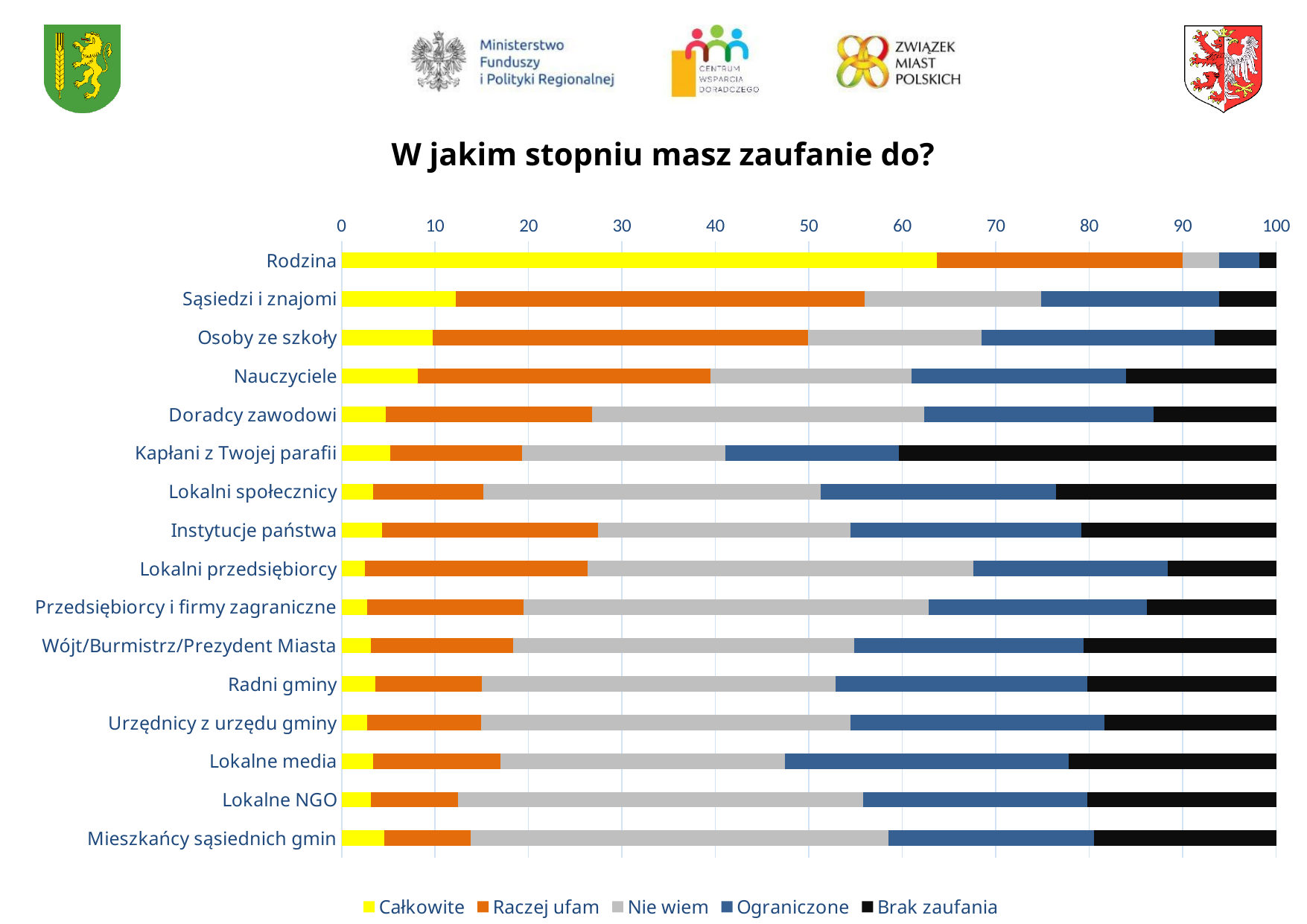
Which has a larger 'Całkowite' segment: Rodzina or Sąsiedzi i znajomi? Rodzina Is the 'Brak zaufania' value for Kapłani z Twojej parafii greater or less than 30? greater Is the 'Całkowite' value for Rodzina greater or less than 60? greater Is the 'Całkowite' value for Nauczyciele greater or less than 10? less How many series does the legend list? 5 What is the title of the chart? W jakim stopniu masz zaufanie do? Which category has the largest 'Brak zaufania' segment? Kapłani z Twojej parafii What kind of chart is shown on the slide? Stacked bar chart Which series is shown in yellow according to the legend? Całkowite Which category has the largest 'Całkowite' segment? Rodzina Which has a larger 'Brak zaufania' segment: Kapłani z Twojej parafii or Rodzina? Kapłani z Twojej parafii How many categories (rows) are plotted in the chart? 16